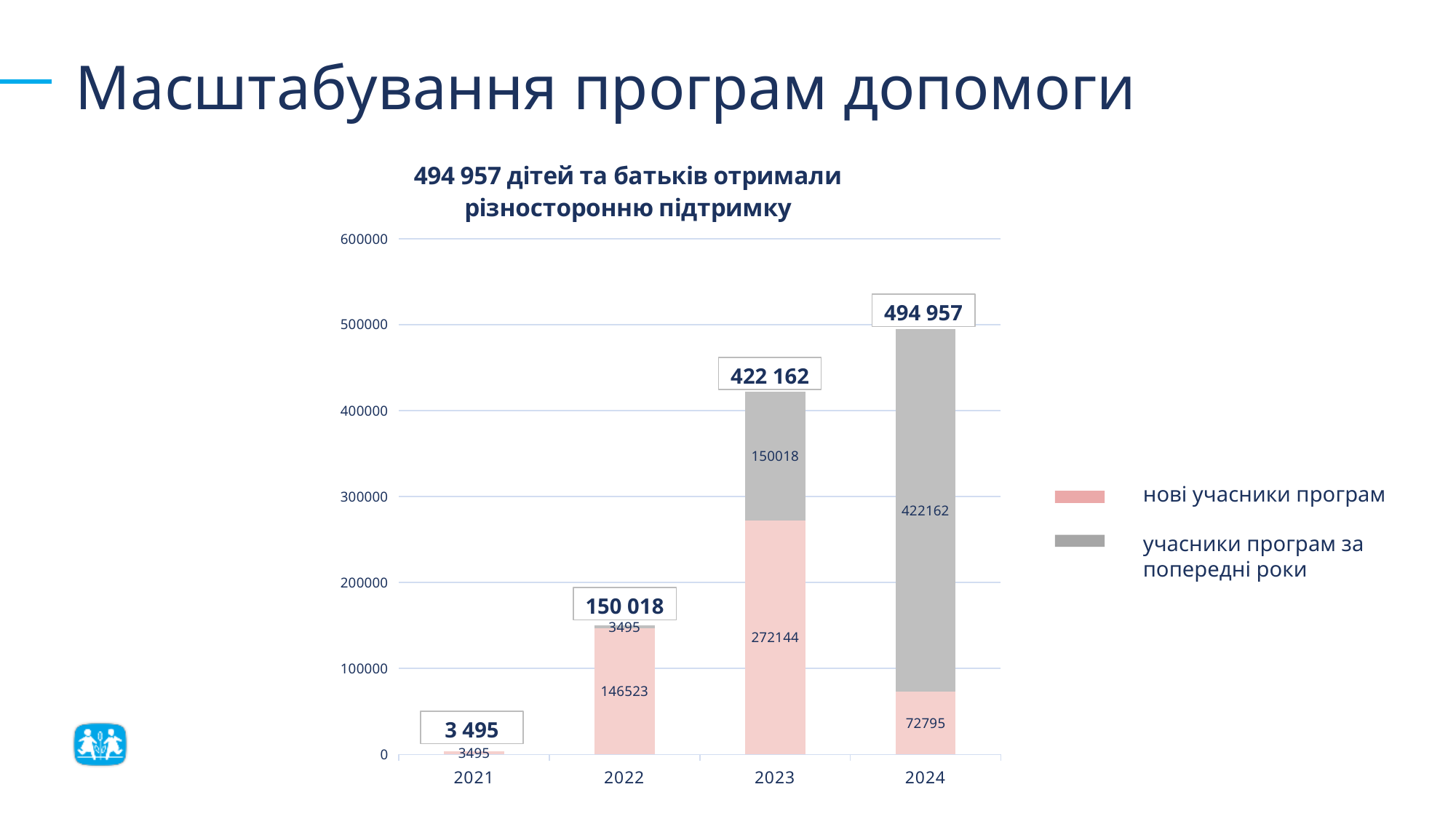
What is the value for participants from previous years (учасники програм за попередні роки) in 2024? 422162 What is the total of the stacked bar for 2022? 150 018 How many series does the legend list? 2 Which is larger: new participants in 2022 or new participants in 2024? new participants in 2022 Which year has the highest total? 2024 How many years are shown on the x axis? 4 What kind of chart is shown on the slide? stacked bar chart What is the difference between the new participants in 2023 and the new participants in 2024? 199349 Which year has the lowest total? 2021 What is the value for new programme participants (нові учасники програм) in 2022? 146523 What is the total of the stacked bar for 2024? 494 957 What is the value for new programme participants (нові учасники програм) in 2023? 272144